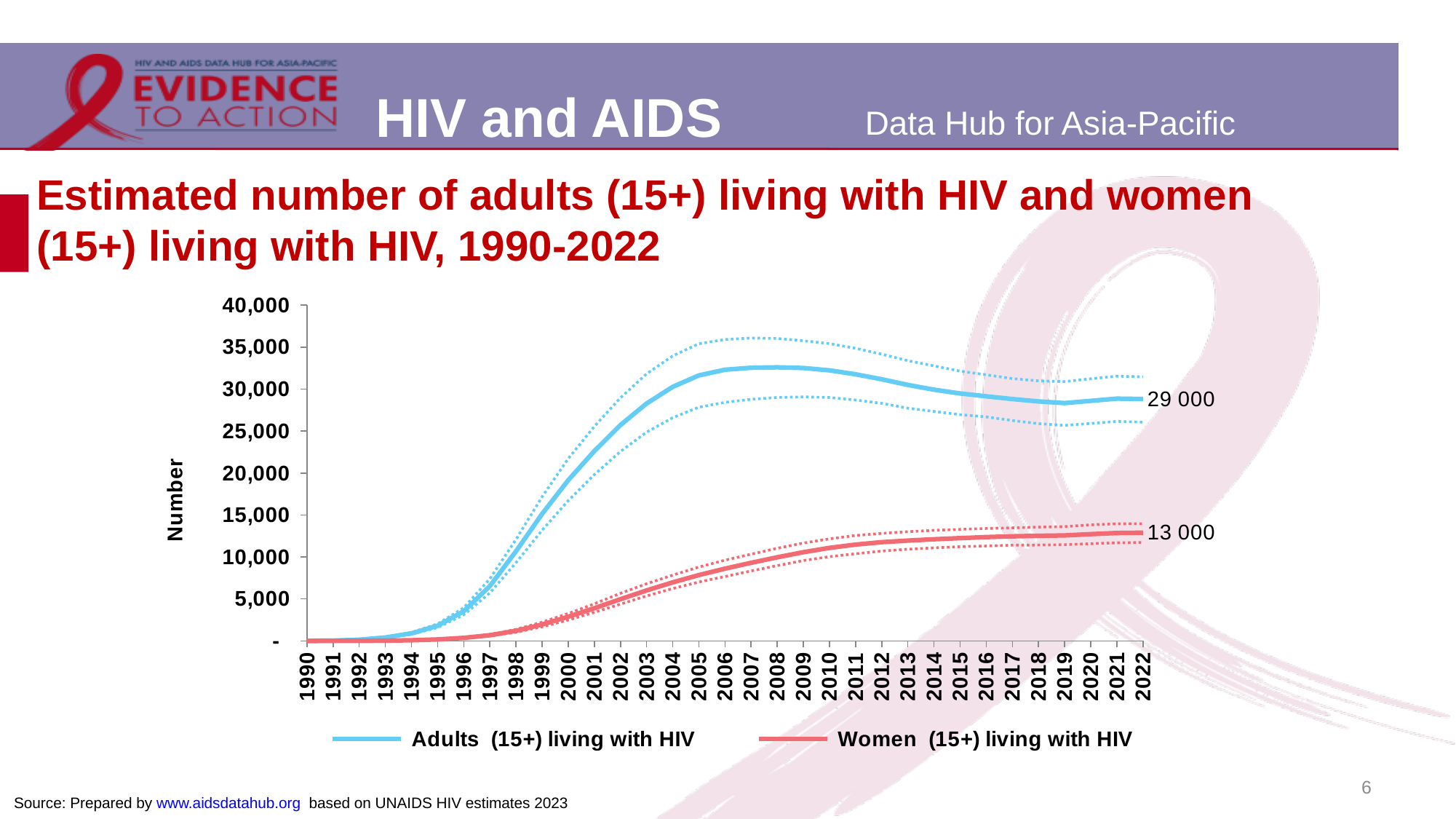
Is the value for Adults (15+) living with HIV in 1995 greater or less than 5,000? less In 2022, which series has the larger value: Adults (15+) living with HIV or Women (15+) living with HIV? Adults (15+) living with HIV What is the labelled value for Adults (15+) living with HIV in 2022? 29 000 Is the value for Adults (15+) living with HIV in 2010 greater or less than 25,000? greater Is the value for Women (15+) living with HIV in 2005 greater or less than 10,000? less How many years are shown on the x axis of the chart? 33 Does the Women (15+) living with HIV line rise or fall from 1990 to 2022? Rise What is the title of the y axis? Number What kind of chart is shown on the slide? Line chart How many series does the legend list? 2 What is the labelled value for Women (15+) living with HIV in 2022? 13 000 What is the difference between the 2022 values for Adults (15+) living with HIV and Women (15+) living with HIV? 16 000